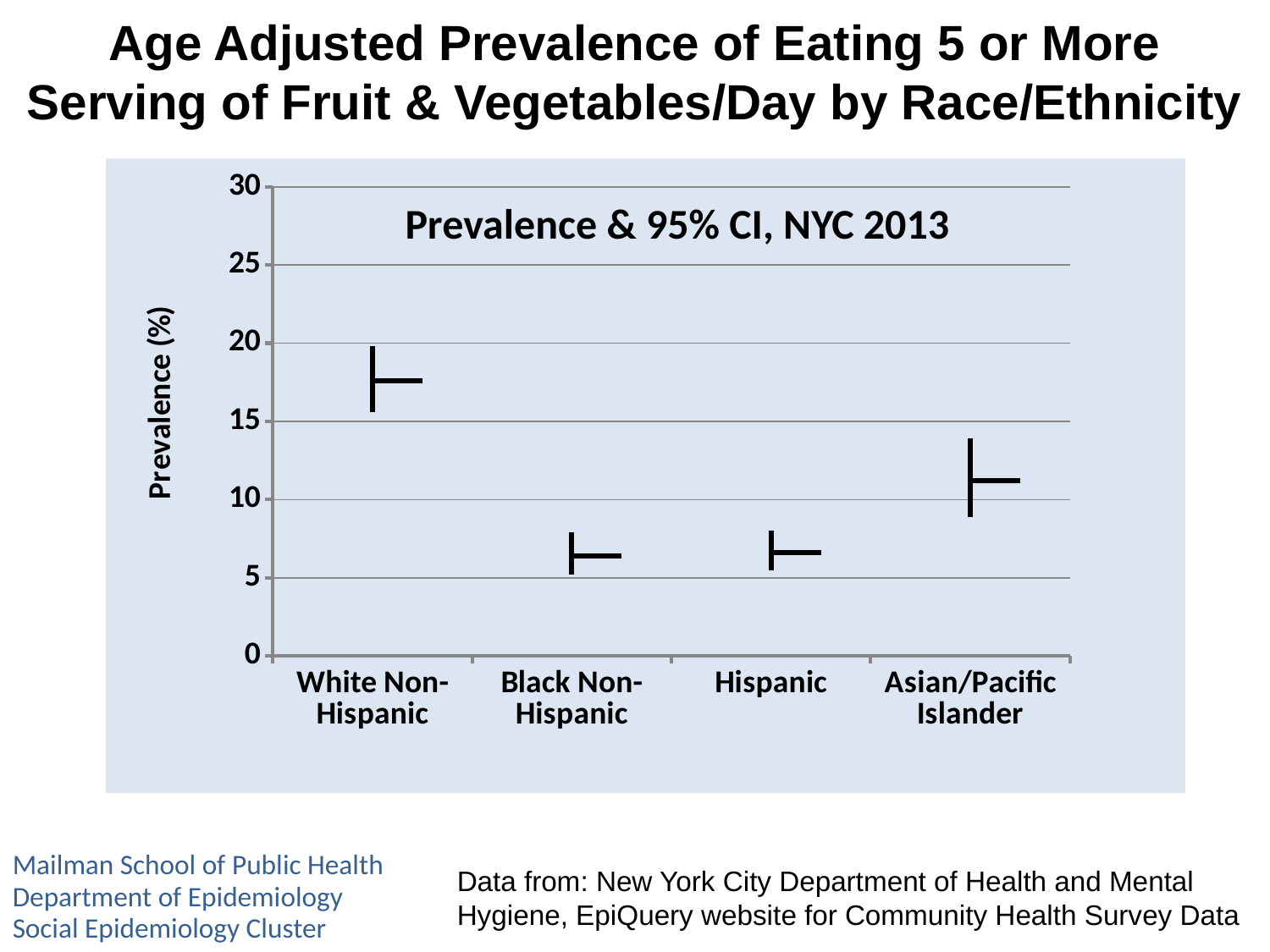
Is the prevalence for White Non-Hispanic greater or less than 15? greater What is the label of the y axis? Prevalence (%) Which has a higher prevalence, Asian/Pacific Islander or Black Non-Hispanic? Asian/Pacific Islander Is the prevalence for Hispanic greater or less than 10? less Is the prevalence for Black Non-Hispanic greater or less than 10? less Which race/ethnicity group has the highest prevalence of eating 5 or more servings of fruit and vegetables per day? White Non-Hispanic What is the title shown inside the chart area? Prevalence & 95% CI, NYC 2013 How many race/ethnicity groups are shown on the x axis? 4 Which has a higher prevalence, White Non-Hispanic or Asian/Pacific Islander? White Non-Hispanic